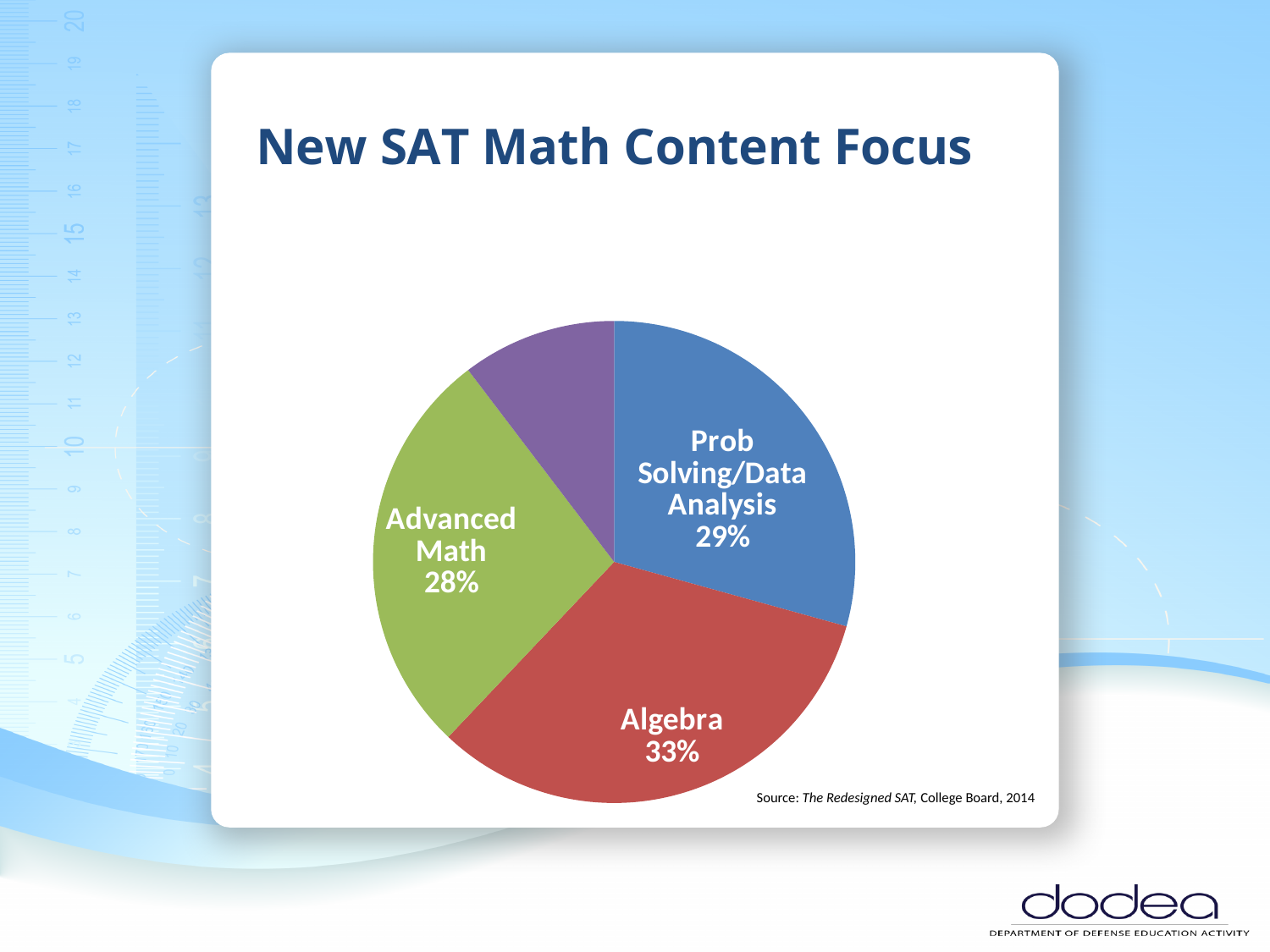
What kind of chart is shown on the slide? Pie chart How many slices does the pie chart have? 4 What is the difference in percentage points between Algebra and Advanced Math? 5 Which labeled slice has the smallest share of the pie? Advanced Math Which is larger, the share for Algebra or the share for Prob Solving/Data Analysis? Algebra What is the combined share of Algebra and Advanced Math? 61% What colour is the Algebra slice? Red What is the title of the chart on the slide? New SAT Math Content Focus Which labeled slice has the largest share of the pie? Algebra What percentage of the pie is Advanced Math? 28% What percentage of the pie is Prob Solving/Data Analysis? 29% What percentage of the pie is Algebra? 33%